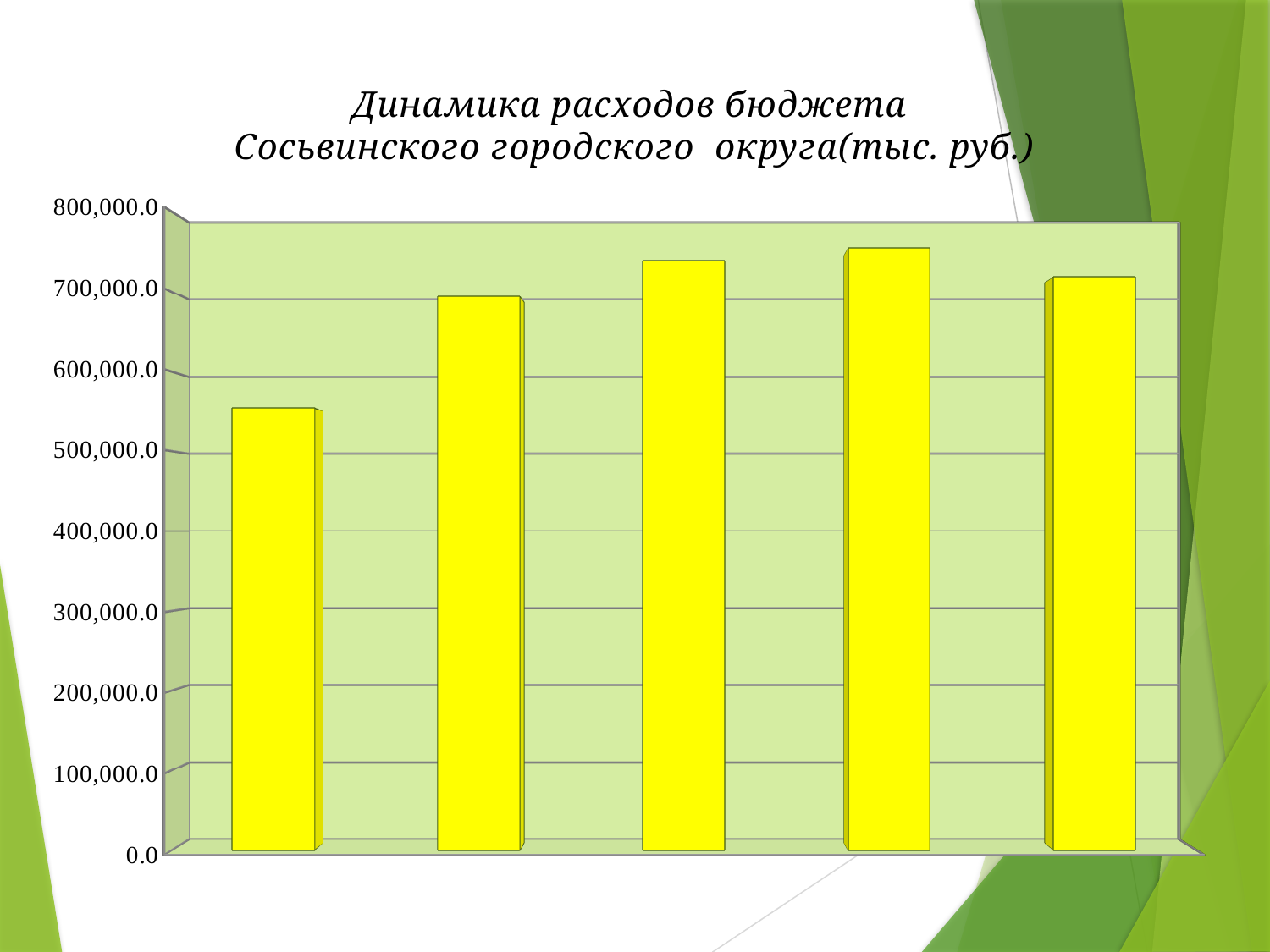
Which is larger, the first bar or the second bar? the second bar What kind of chart is shown on the slide? bar chart What is the highest value shown on the vertical axis? 800,000.0 How many bars are plotted in the chart? 5 Which bar is the highest in the chart? the fourth bar Is the value of the first bar greater or less than 600,000.0? less Which bar is the lowest in the chart? the first bar Is the value of the third bar greater or less than 700,000.0? greater Do the values rise or fall from the first bar to the fourth bar? rise Is the value of the fourth bar greater or less than 800,000.0? less Which is larger, the fourth bar or the fifth bar? the fourth bar